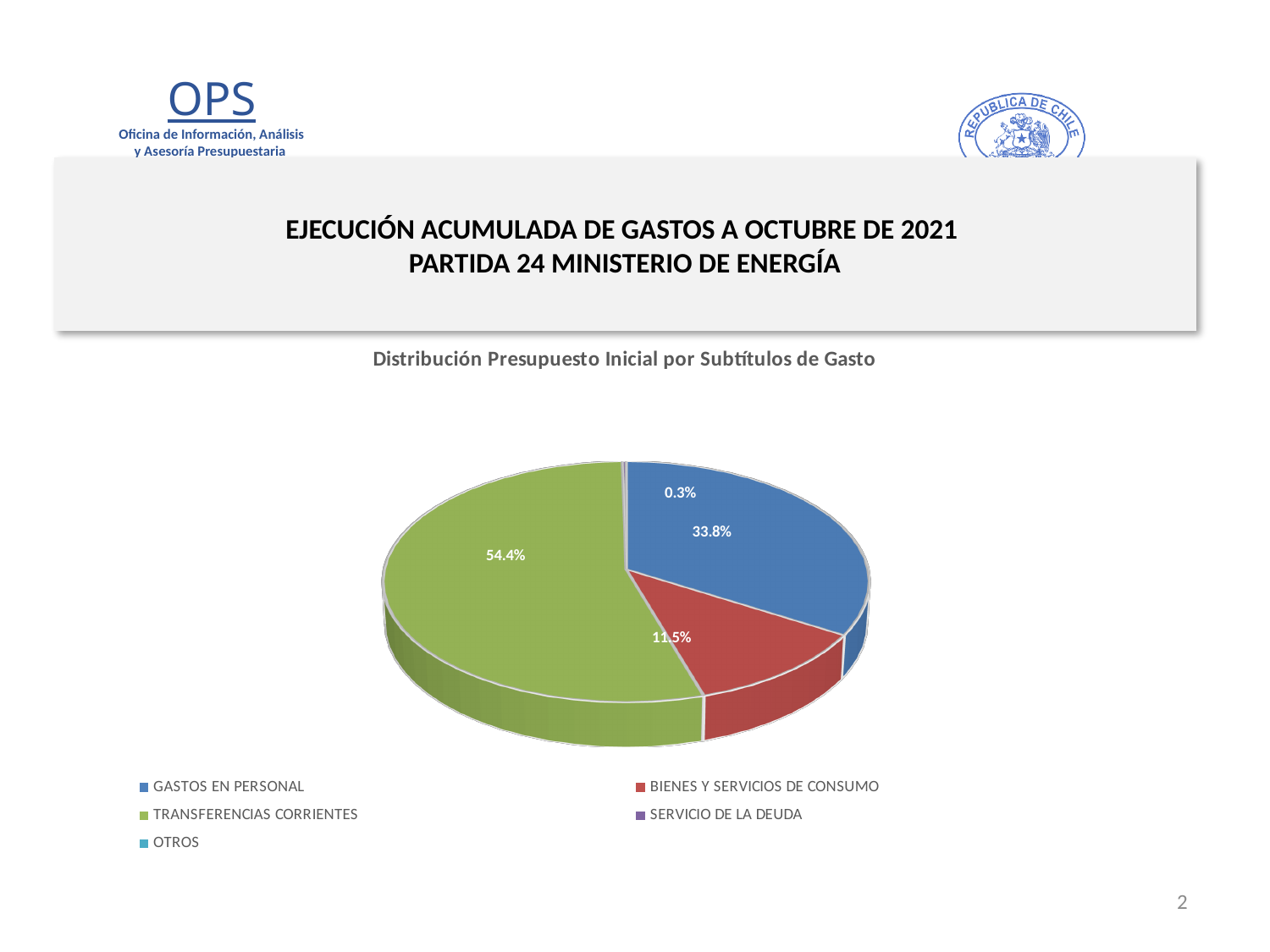
What share of the pie does GASTOS EN PERSONAL represent? 33.8% How many categories does the legend list? 5 What share of the pie does TRANSFERENCIAS CORRIENTES represent? 54.4% What share of the pie does BIENES Y SERVICIOS DE CONSUMO represent? 11.5% What is the difference in percentage points between GASTOS EN PERSONAL and BIENES Y SERVICIOS DE CONSUMO? 22.3 What colour is the slice for TRANSFERENCIAS CORRIENTES? Green What kind of chart is shown on the slide? Pie chart What is the title of the chart? Distribución Presupuesto Inicial por Subtítulos de Gasto What is the difference in percentage points between TRANSFERENCIAS CORRIENTES and GASTOS EN PERSONAL? 20.6 Which category has the largest share of the pie? TRANSFERENCIAS CORRIENTES Which is larger, the share for GASTOS EN PERSONAL or the share for BIENES Y SERVICIOS DE CONSUMO? GASTOS EN PERSONAL What is the smallest percentage labelled on the pie? 0.3%